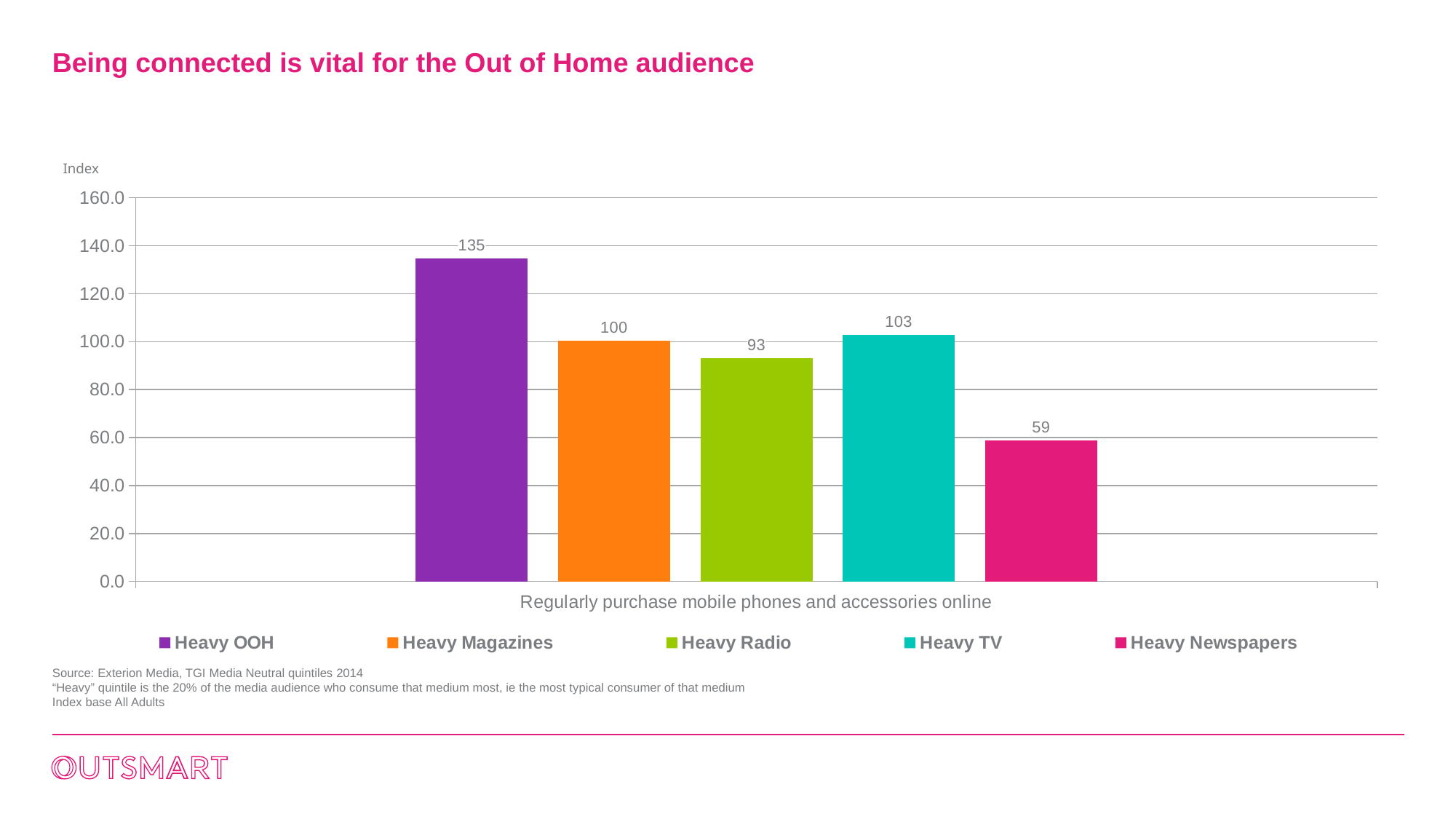
What is the difference between the index values for Heavy TV and Heavy Radio? 10 Which series has the lowest index value? Heavy Newspapers What kind of chart is shown on the slide? Bar chart Which series has the highest index value? Heavy OOH What is the index value for Heavy OOH? 135 Is the value for Heavy Newspapers greater or less than 60.0? less What is the index value for Heavy Newspapers? 59 How many series does the legend list? 5 Which is larger, the index value for Heavy Radio or Heavy TV? Heavy TV What is the difference between the index values for Heavy OOH and Heavy Magazines? 35 What is the index value for Heavy TV? 103 What is the category label shown on the x axis? Regularly purchase mobile phones and accessories online